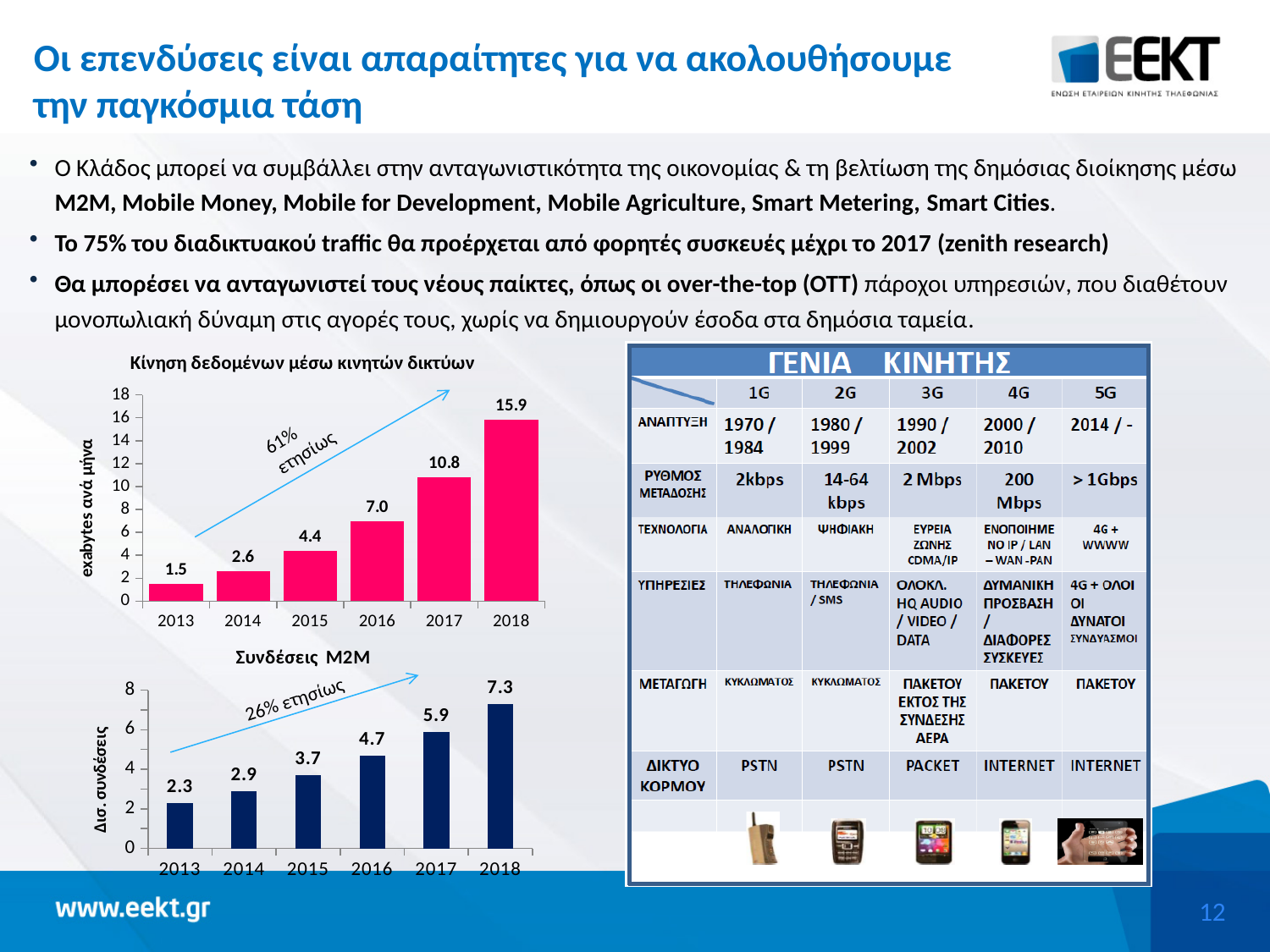
In the chart 'Κίνηση δεδομένων μέσω κινητών δικτύων', which year has the highest value? 2018 In the chart 'Συνδέσεις M2M', what is the difference between the values for 2017 and 2013? 3.6 In the chart 'Κίνηση δεδομένων μέσω κινητών δικτύων', do the values rise or fall from 2013 to 2018? rise In the chart 'Κίνηση δεδομένων μέσω κινητών δικτύων', what is the value for 2016? 7.0 In the chart 'Συνδέσεις M2M', which is larger, the value for 2014 or the value for 2016? 2016 What is the y-axis label of the chart 'Κίνηση δεδομένων μέσω κινητών δικτύων'? exabytes ανά μήνα What kind of chart is 'Συνδέσεις M2M'? bar chart In the chart 'Κίνηση δεδομένων μέσω κινητών δικτύων', what is the difference between the values for 2018 and 2017? 5.1 In the chart 'Κίνηση δεδομένων μέσω κινητών δικτύων', which year has the lowest value? 2013 In the chart 'Κίνηση δεδομένων μέσω κινητών δικτύων', how many years are shown on the x axis? 6 In the chart 'Συνδέσεις M2M', what is the value for 2015? 3.7 In the chart 'Συνδέσεις M2M', what is the value for 2018? 7.3